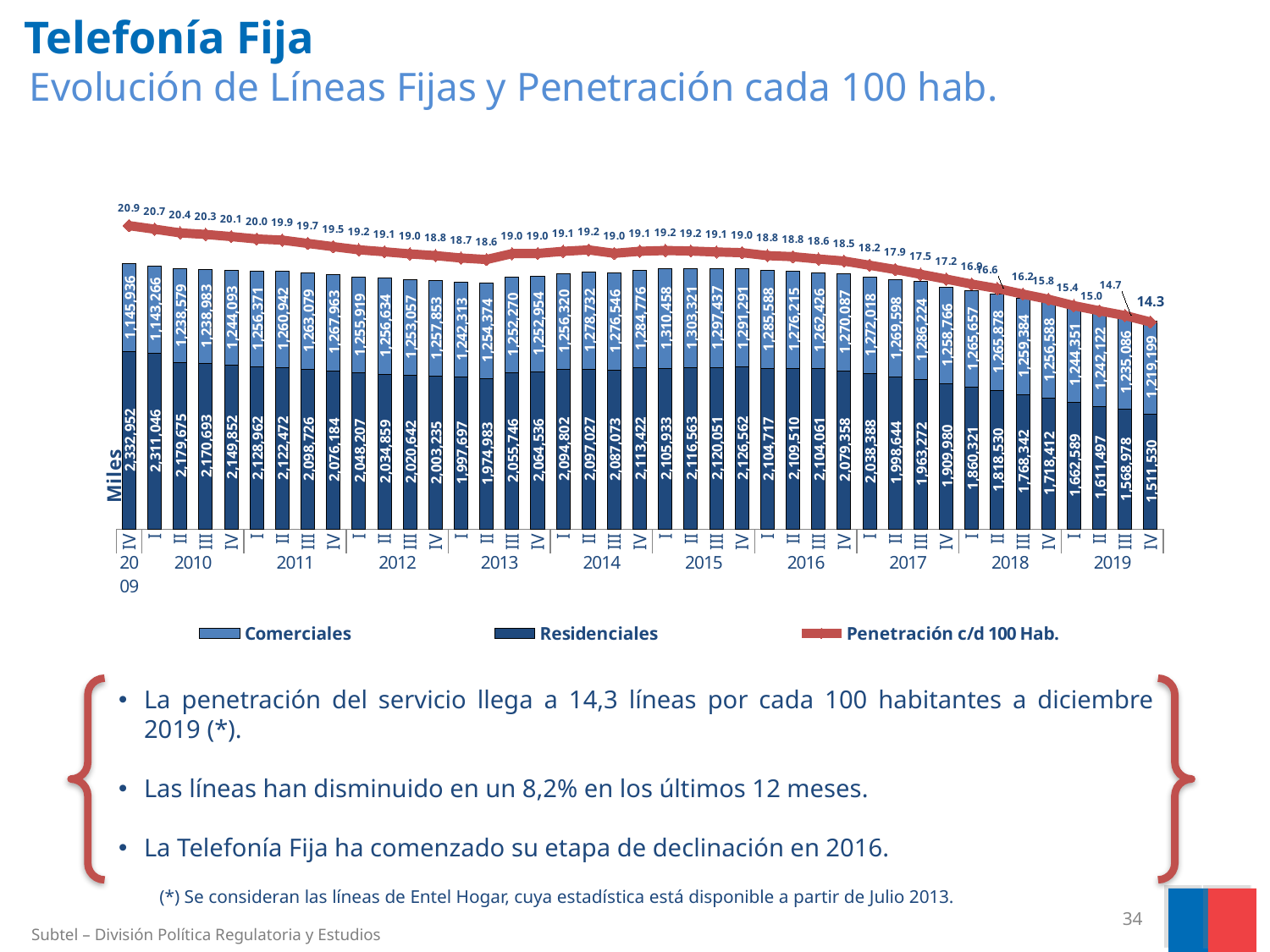
How many series does the legend list? 3 Does the Penetración c/d 100 Hab. line rise or fall overall from IV 2009 to IV 2019? Fall In which quarter is the Residenciales value highest? IV 2009 What is the Penetración c/d 100 Hab. value for IV 2009? 20.9 In which quarter is the Penetración c/d 100 Hab. value lowest? IV 2019 What is the Penetración c/d 100 Hab. value for IV 2019? 14.3 What is the total of the stacked bar (Comerciales plus Residenciales) for IV 2019? 2,730,729 What is the Comerciales value for IV 2009? 1,145,936 What is the Residenciales value for IV 2019? 1,511,530 What kind of chart is shown on the slide? Combined stacked bar and line chart What is the difference between the Residenciales values for IV 2018 and IV 2019? 206,882 Which is larger, the Comerciales value for I 2015 or the Comerciales value for IV 2019? I 2015